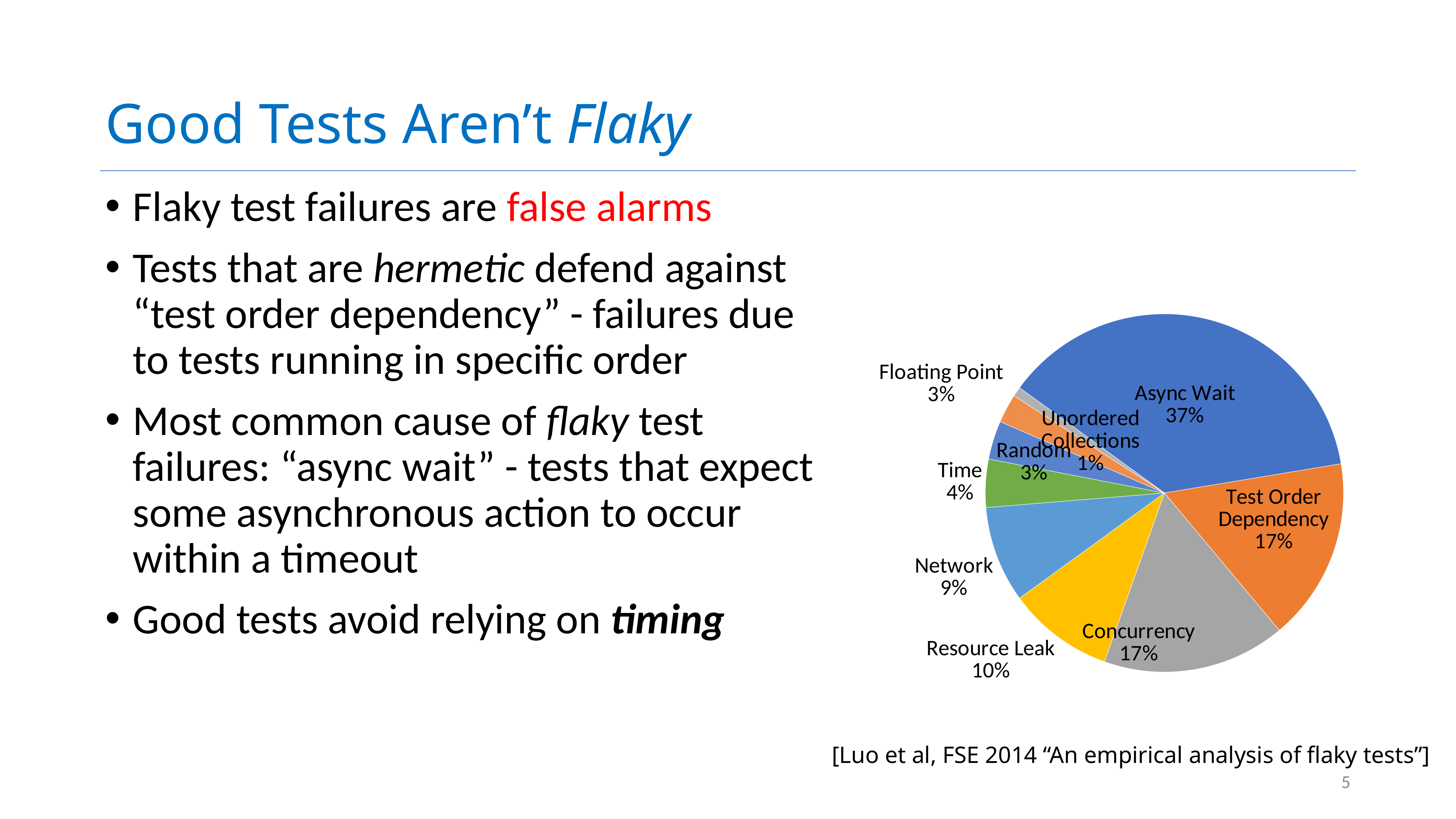
What share of the pie does Async Wait account for? 37% What kind of chart is shown on the slide? pie chart What is the value shown for Resource Leak? 10% What colour is the Async Wait slice? blue What is the difference between the Async Wait share and the Test Order Dependency share? 20% What is the value shown for Network? 9% What is the value shown for Time? 4% Which is larger, the Resource Leak slice or the Network slice? Resource Leak How many categories are shown in the pie chart? 9 What is the value shown for Unordered Collections? 1% Which category has the largest slice of the pie? Async Wait Which category has the smallest slice of the pie? Unordered Collections